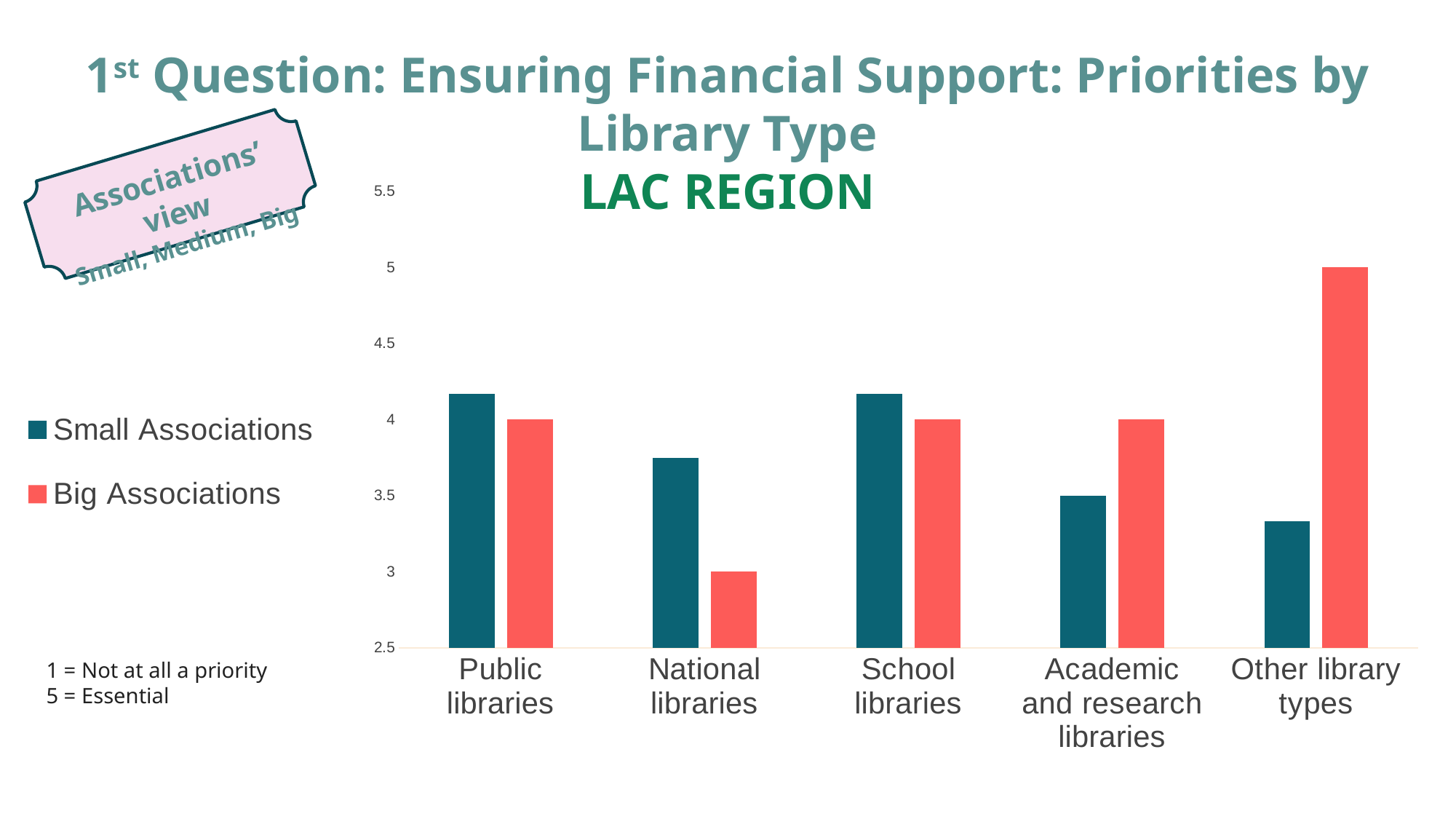
What is the value for Big Associations for National libraries? 3 What is the difference between the Big Associations values for Other library types and National libraries? 2 For Big Associations, which library type has the lowest value? National libraries For Other library types, which series has the larger value, Small Associations or Big Associations? Big Associations What is the value for Big Associations for Other library types? 5 Is the value for Small Associations for Public libraries greater or less than 4? greater How many series does the legend list? 2 What is the value for Small Associations for Academic and research libraries? 3.5 For Big Associations, which library type has the highest value? Other library types What kind of chart is shown on the slide? bar chart Is the value for Small Associations for Other library types greater or less than 3.5? less How many library types are shown on the x axis? 5